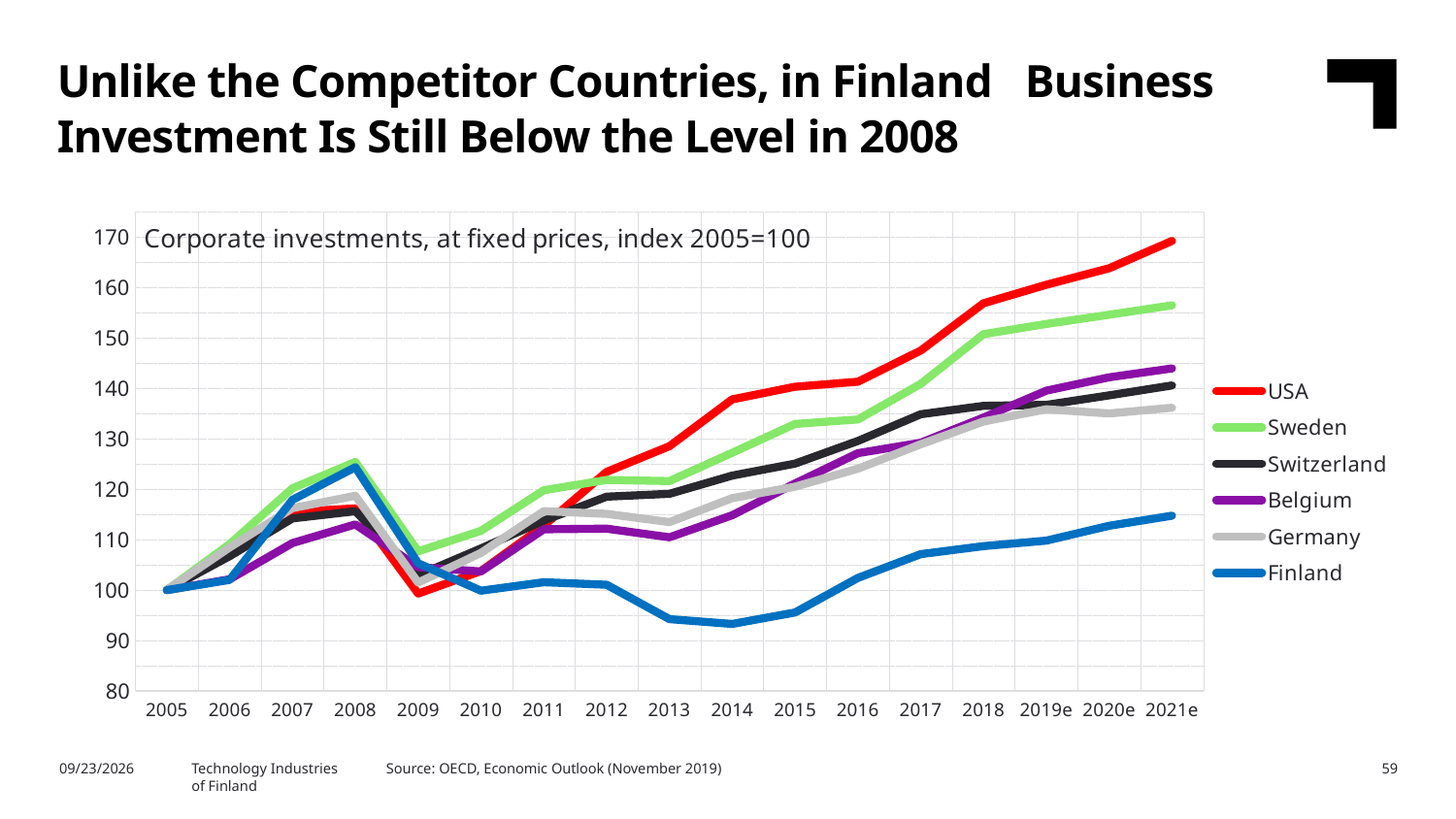
Which country has the lowest value in 2021e? Finland What kind of chart is shown on the slide? Line chart Is the value for USA in 2021e greater or less than 160? greater What is the index value for Finland in 2005? 100 Which is larger in 2021e, the value for Sweden or the value for Germany? Sweden Does the value for Finland rise or fall from 2014 to 2021e? Rise How many series does the legend list? 6 Which country has the highest value in 2021e? USA Is the value for Sweden in 2021e greater or less than 150? greater How many years are shown along the x axis? 17 Is the value for Finland in 2014 greater or less than 100? less What is the title shown inside the chart area? Corporate investments, at fixed prices, index 2005=100